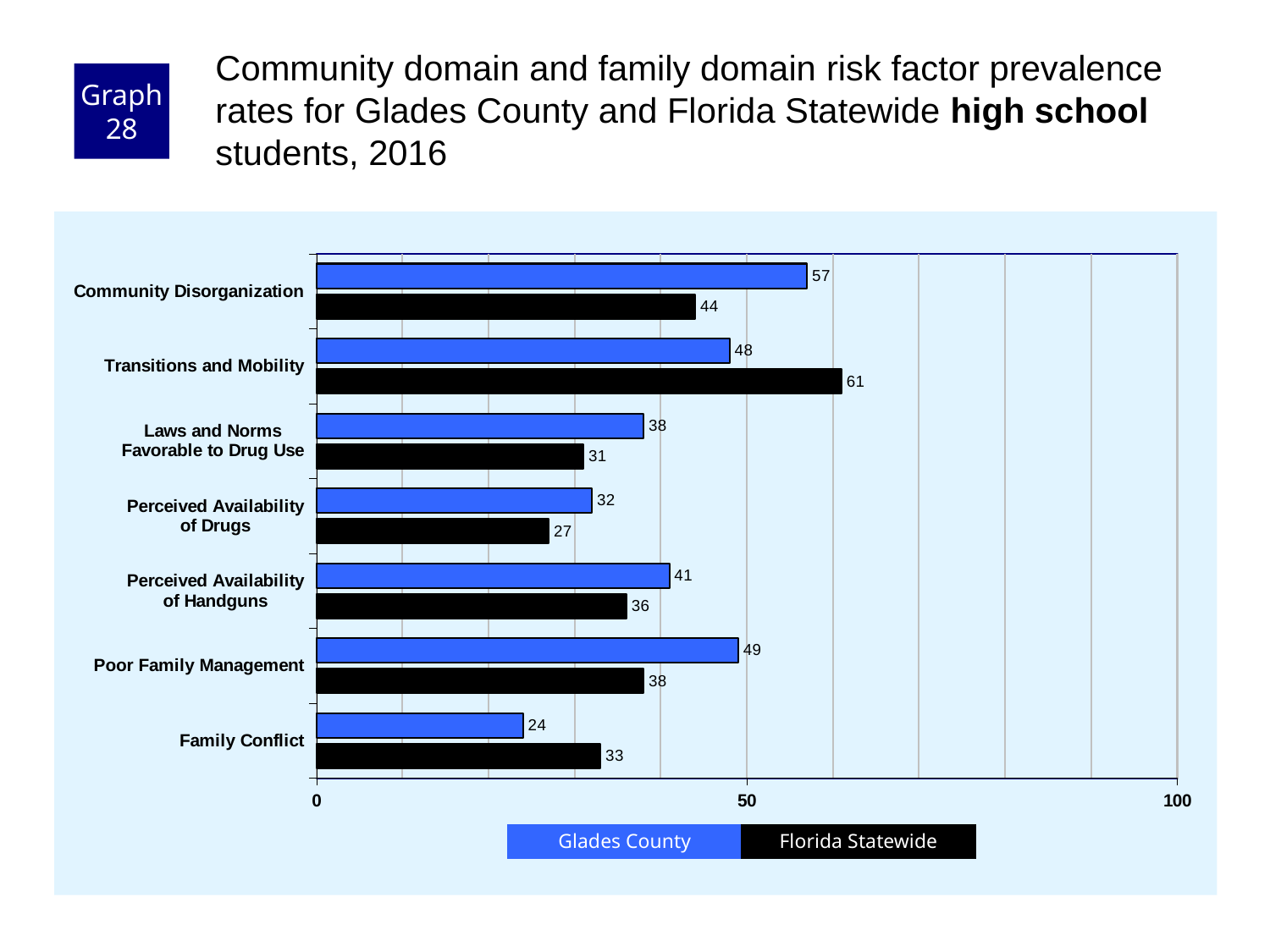
What is the Glades County value for Family Conflict? 24 How many series does the legend list? 2 What is the Glades County value for Community Disorganization? 57 What is the Florida Statewide value for Transitions and Mobility? 61 Which risk factor has the lowest Florida Statewide value? Perceived Availability of Drugs Which is larger for Family Conflict: the Glades County value or the Florida Statewide value? Florida Statewide Which colour represents Florida Statewide in the chart? black What is the difference between the Glades County and Florida Statewide values for Poor Family Management? 11 How many risk factors are shown on the chart? 7 Is the Glades County value for Transitions and Mobility greater or less than 50? less Which risk factor has the highest Glades County value? Community Disorganization What kind of chart is shown on the slide? bar chart